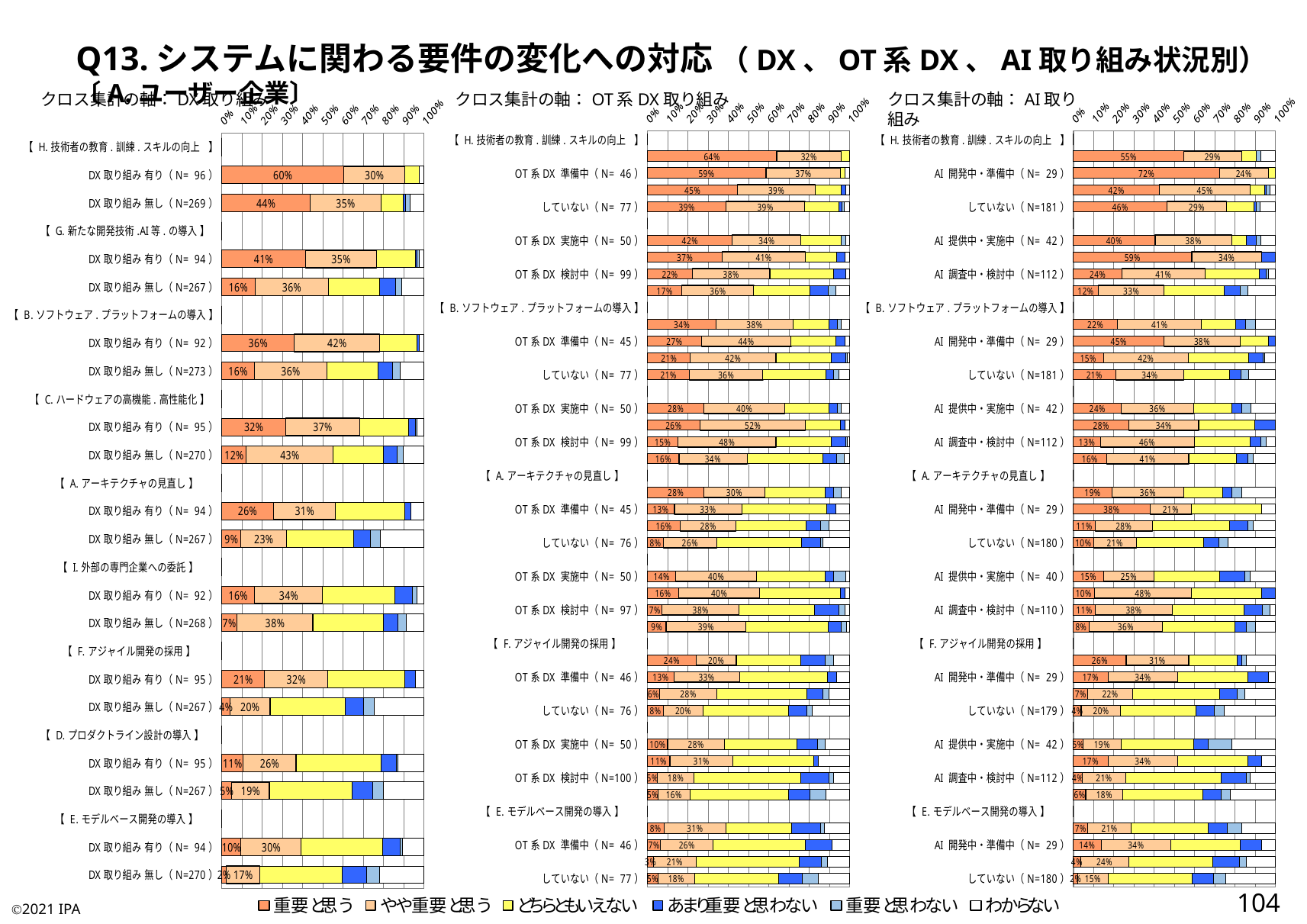
In the left chart (クロス集計の軸: DX取り組み), what is the 重要と思う value for DX取り組み有り under H. 技術者の教育.訓練.スキルの向上? 60% How many series does the legend at the bottom of the slide list? 6 In the left chart (クロス集計の軸: DX取り組み), among the DX取り組み有り rows, which item has the highest 重要と思う share? H. 技術者の教育.訓練.スキルの向上 What kind of chart is used on this slide? Stacked bar chart In the left chart (クロス集計の軸: DX取り組み), what is the 重要と思う value for DX取り組み無し under E. モデルベース開発の導入? 2% In the left chart (クロス集計の軸: DX取り組み), under G. 新たな開発技術.AI等.の導入, which has the larger 重要と思う share: DX取り組み有り or DX取り組み無し? DX取り組み有り In the left chart (クロス集計の軸: DX取り組み), what is the やや重要と思う value for DX取り組み無し under C. ハードウェアの高機能.高性能化? 43% In the left chart (クロス集計の軸: DX取り組み), what is the N for DX取り組み有り under B. ソフトウェア.プラットフォームの導入? 92 In the left chart (クロス集計の軸: DX取り組み), what is the difference in 重要と思う between DX取り組み有り (60%) and DX取り組み無し (44%) under H. 技術者の教育.訓練.スキルの向上? 16% In the left chart (クロス集計の軸: DX取り組み), what is the やや重要と思う value for DX取り組み無し under H. 技術者の教育.訓練.スキルの向上? 35% How many charts are shown on this slide? 3 In the left chart (クロス集計の軸: DX取り組み), what is the difference in やや重要と思う between DX取り組み有り (42%) and DX取り組み無し (36%) under B. ソフトウェア.プラットフォームの導入? 6%